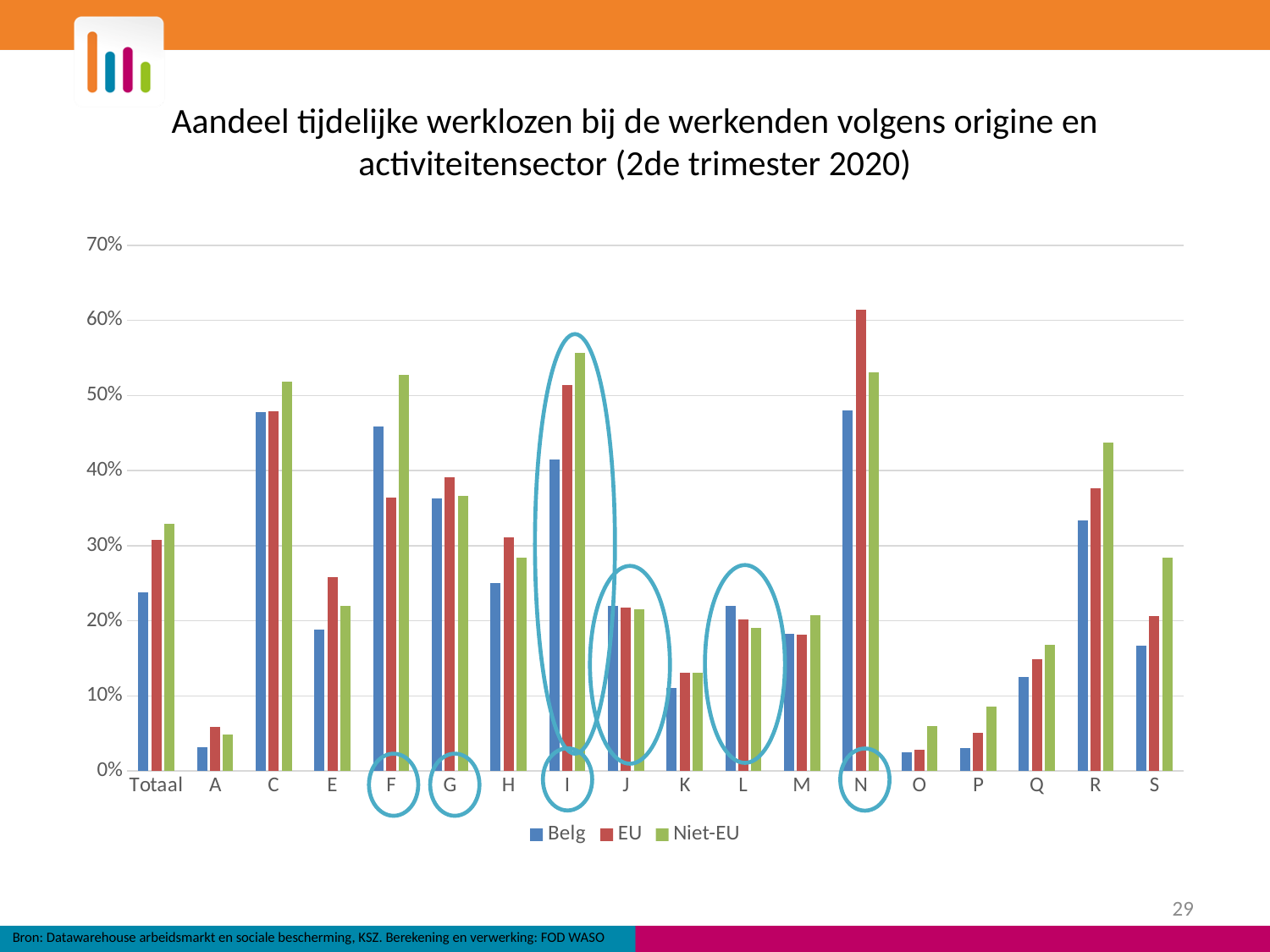
How many series does the legend list? 3 Is the Niet-EU value for F greater or less than 50%? greater Which category has the highest EU value? N For category F, which is larger: the Belg value or the EU value? Belg Is the Niet-EU value for R greater or less than 40%? greater Is the EU value for N greater or less than 50%? greater Which series is shown in green in the legend? Niet-EU For category N, which is larger: the Belg value or the EU value? EU What kind of chart is shown on the slide? bar chart How many categories are shown on the x axis? 18